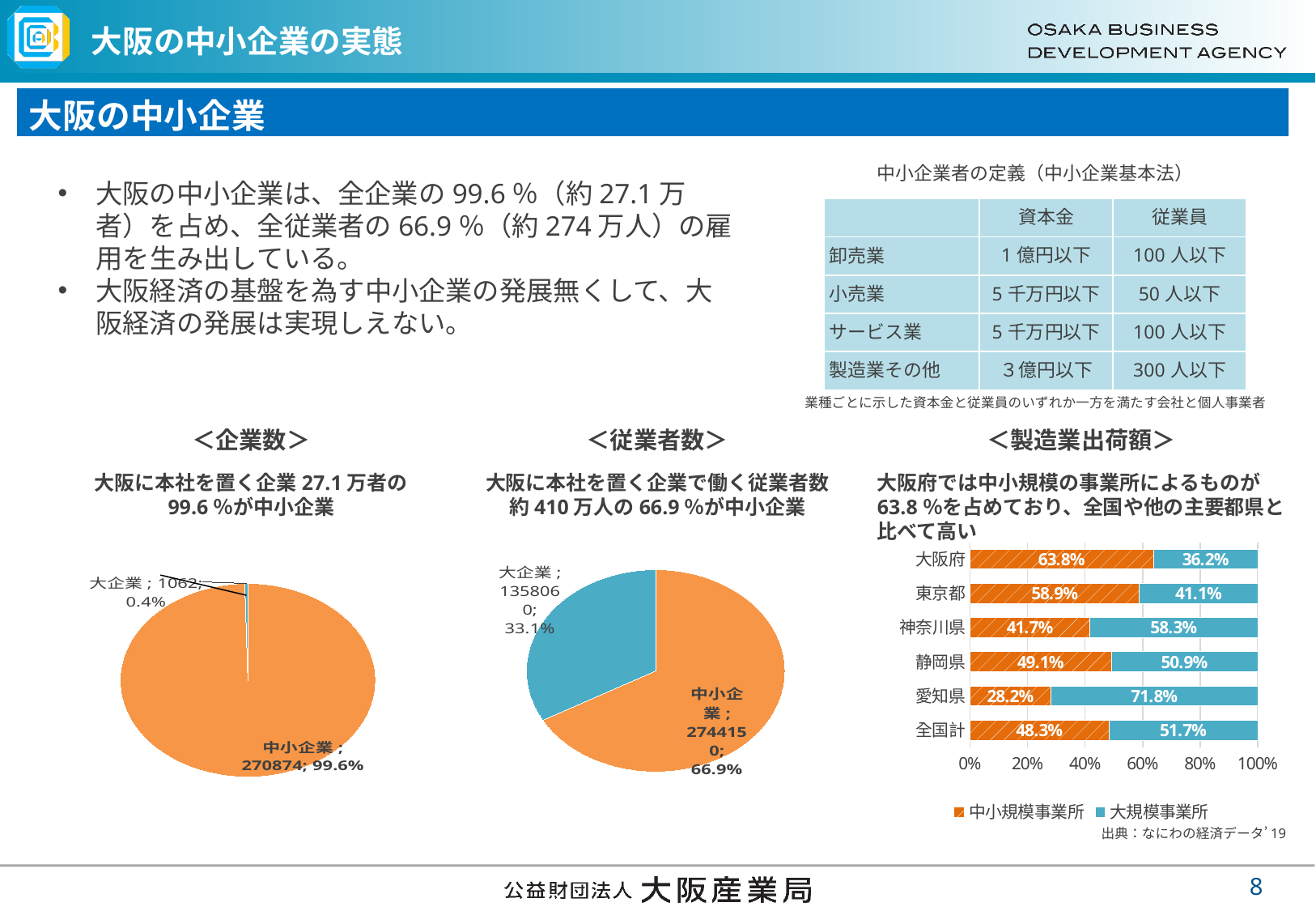
In the <企業数> pie chart, what share does 中小企業 hold? 99.6% What kind of chart is the <製造業出荷額> chart? Stacked bar chart How many categories are shown in the <製造業出荷額> bar chart? 6 In the <製造業出荷額> bar chart, what is the value for 大規模事業所 in 愛知県? 71.8% In the <製造業出荷額> bar chart, which category has the lowest 中小規模事業所 share? 愛知県 In the <従業者数> pie chart, what is the value shown for 大企業? 1358060 In the <製造業出荷額> bar chart, what is the value for 中小規模事業所 in 大阪府? 63.8% In the <製造業出荷額> bar chart, which is larger: the 中小規模事業所 value for 東京都 or for 静岡県? 東京都 In the <製造業出荷額> bar chart, which category has the highest 中小規模事業所 share? 大阪府 In the <製造業出荷額> bar chart, what is the difference between the 中小規模事業所 values for 大阪府 and 全国計? 15.5% What kind of chart is the <従業者数> chart? Pie chart How many series does the legend of the <製造業出荷額> chart list? 2